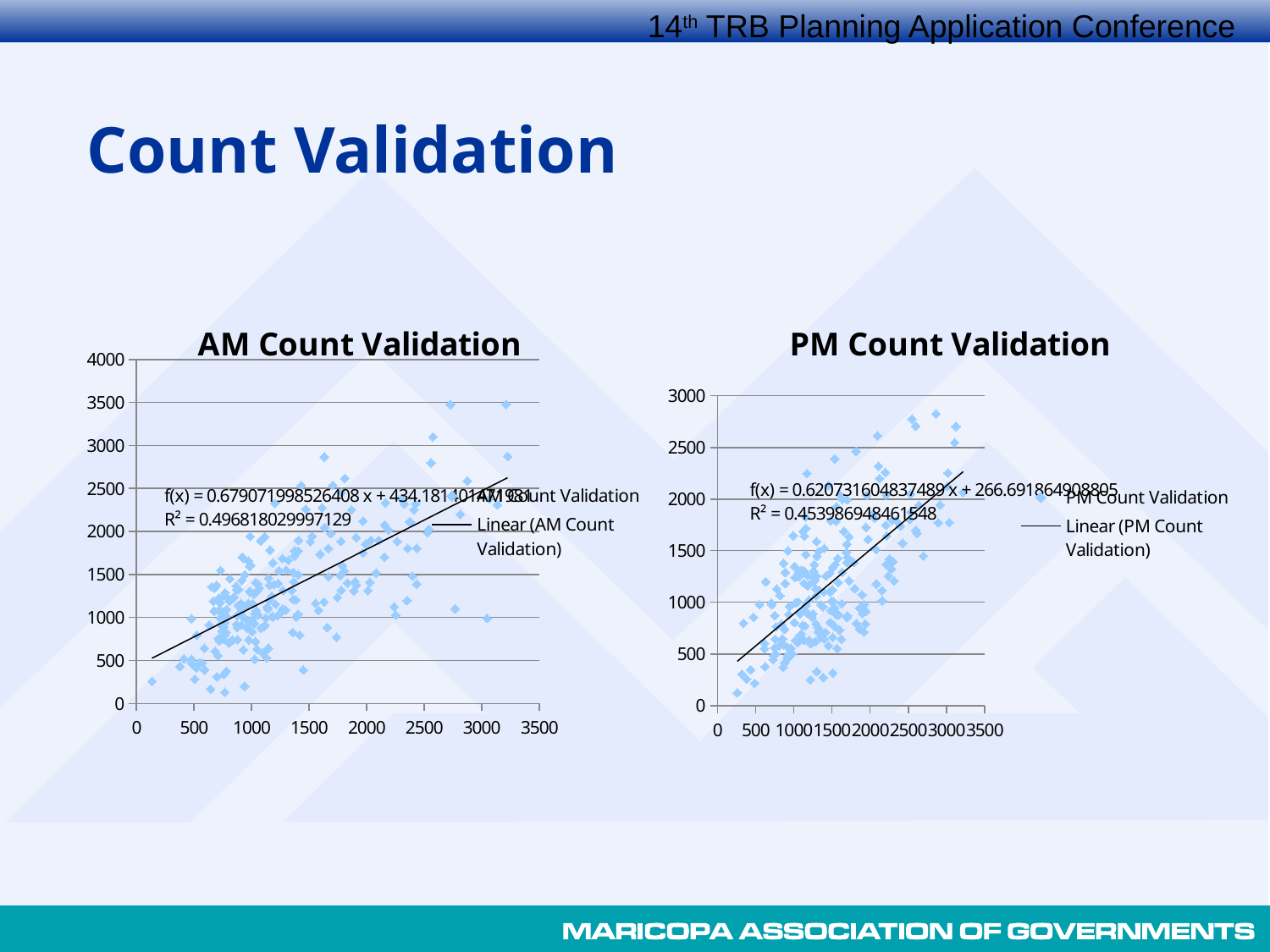
How many entries does the legend of the AM Count Validation chart list? 2 What is the slope of the fitted line shown on the AM Count Validation chart? 0.679071998526408 What is the R² value shown on the AM Count Validation chart? 0.496818029997129 Which chart has the higher R² value, AM Count Validation or PM Count Validation? AM Count Validation What is the R² value shown on the PM Count Validation chart? 0.453986948461548 What is the slope of the fitted line shown on the PM Count Validation chart? 0.620731604837489 How many entries does the legend of the PM Count Validation chart list? 2 What is the highest value labelled on the y-axis of the AM Count Validation chart? 4000 What kind of chart is the PM Count Validation chart? scatter chart In the PM Count Validation chart, do the plotted values generally rise or fall as the x-axis value increases? rise What kind of chart is the AM Count Validation chart? scatter chart What is the intercept of the fitted line shown on the PM Count Validation chart? 266.691864908805